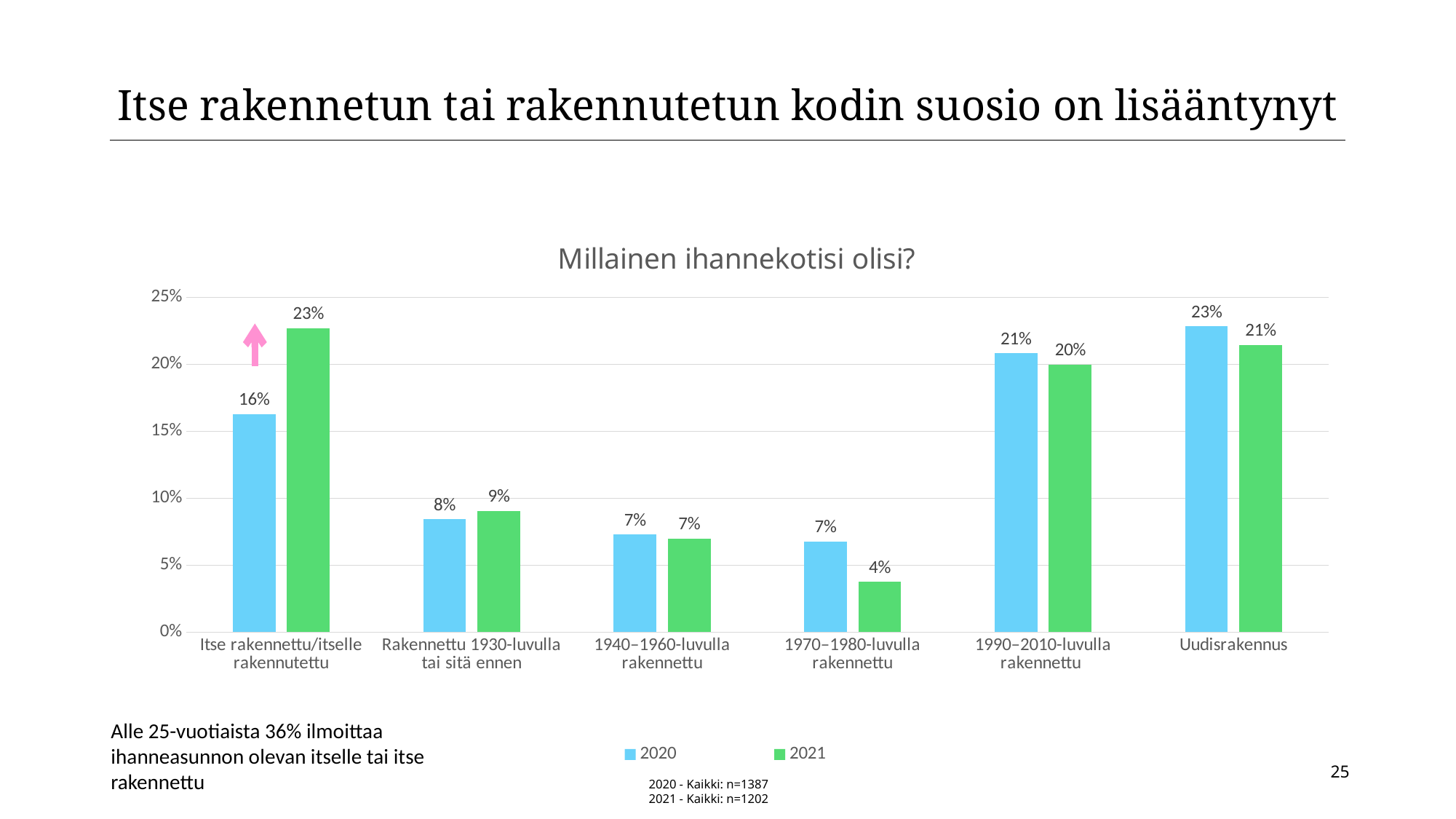
What is the 2020 value for "Uudisrakennus"? 23% By how many percentage points did the value for "Itse rakennettu/itselle rakennutettu" change from 2020 to 2021? 7 percentage points Which is larger for "1990–2010-luvulla rakennettu": the 2020 value or the 2021 value? 2020 What kind of chart is shown on the slide? Bar chart What is the 2021 value for "Itse rakennettu/itselle rakennutettu"? 23% Which category has the lowest 2021 value? 1970–1980-luvulla rakennettu What is the 2021 value for "1970–1980-luvulla rakennettu"? 4% How many series does the legend list? 2 What is the title of the chart? Millainen ihannekotisi olisi? What is the 2020 value for "Rakennettu 1930-luvulla tai sitä ennen"? 8% How many categories are shown on the x axis? 6 Which category has the highest 2021 value? Itse rakennettu/itselle rakennutettu